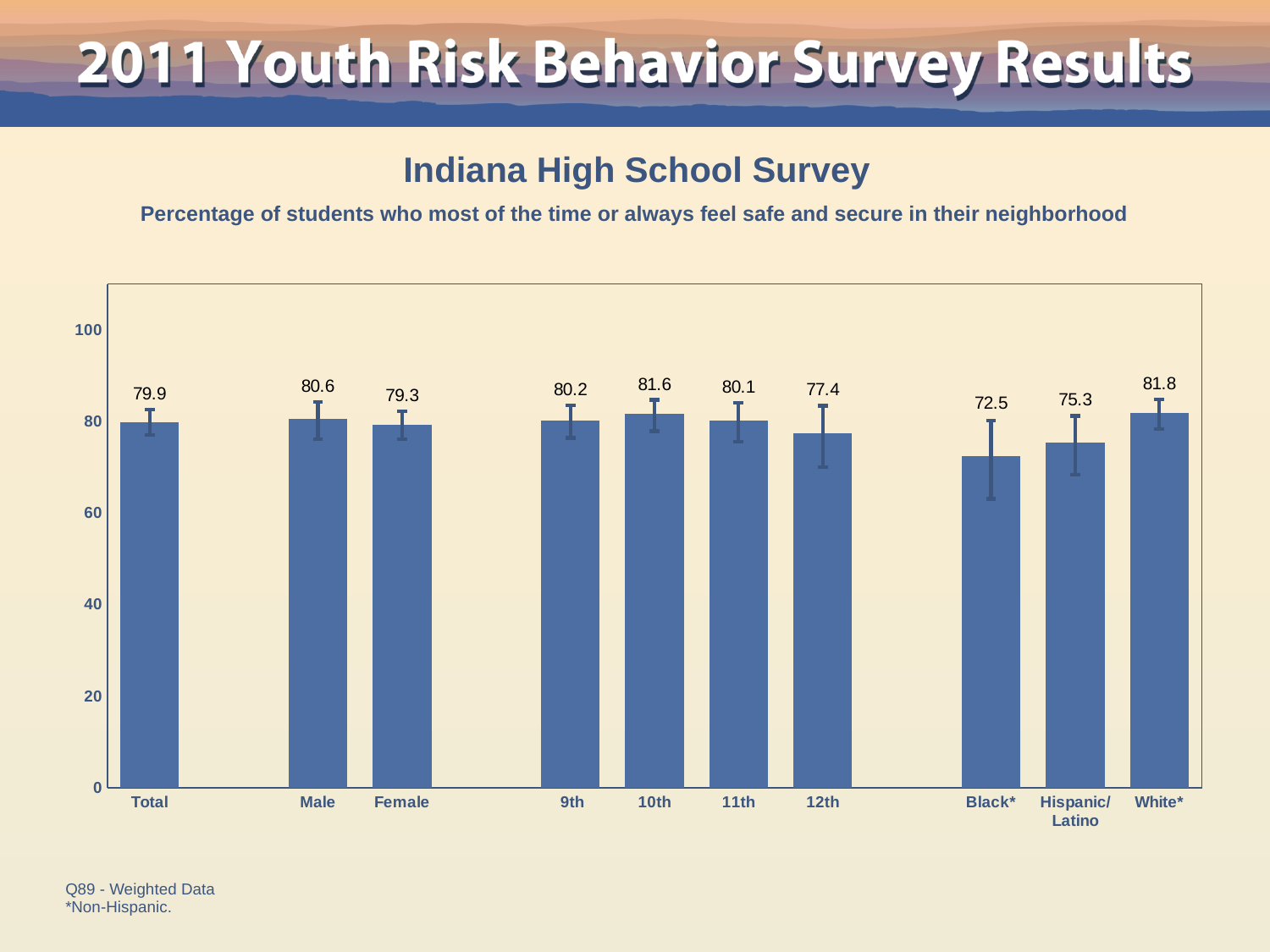
Which is larger, the value for 10th or the value for 12th? 10th How many categories are shown on the chart? 10 What is the value for Female? 79.3 What is the difference between the values for White* and Black*? 9.3 What is the value for Hispanic/Latino? 75.3 What kind of chart is shown on the slide? bar chart What is the difference between the values for Male and Female? 1.3 Which category has the highest value? White* Is the value for Black* greater or less than 80? less What is the value for Total? 79.9 What is the value for 12th? 77.4 Which category has the lowest value? Black*